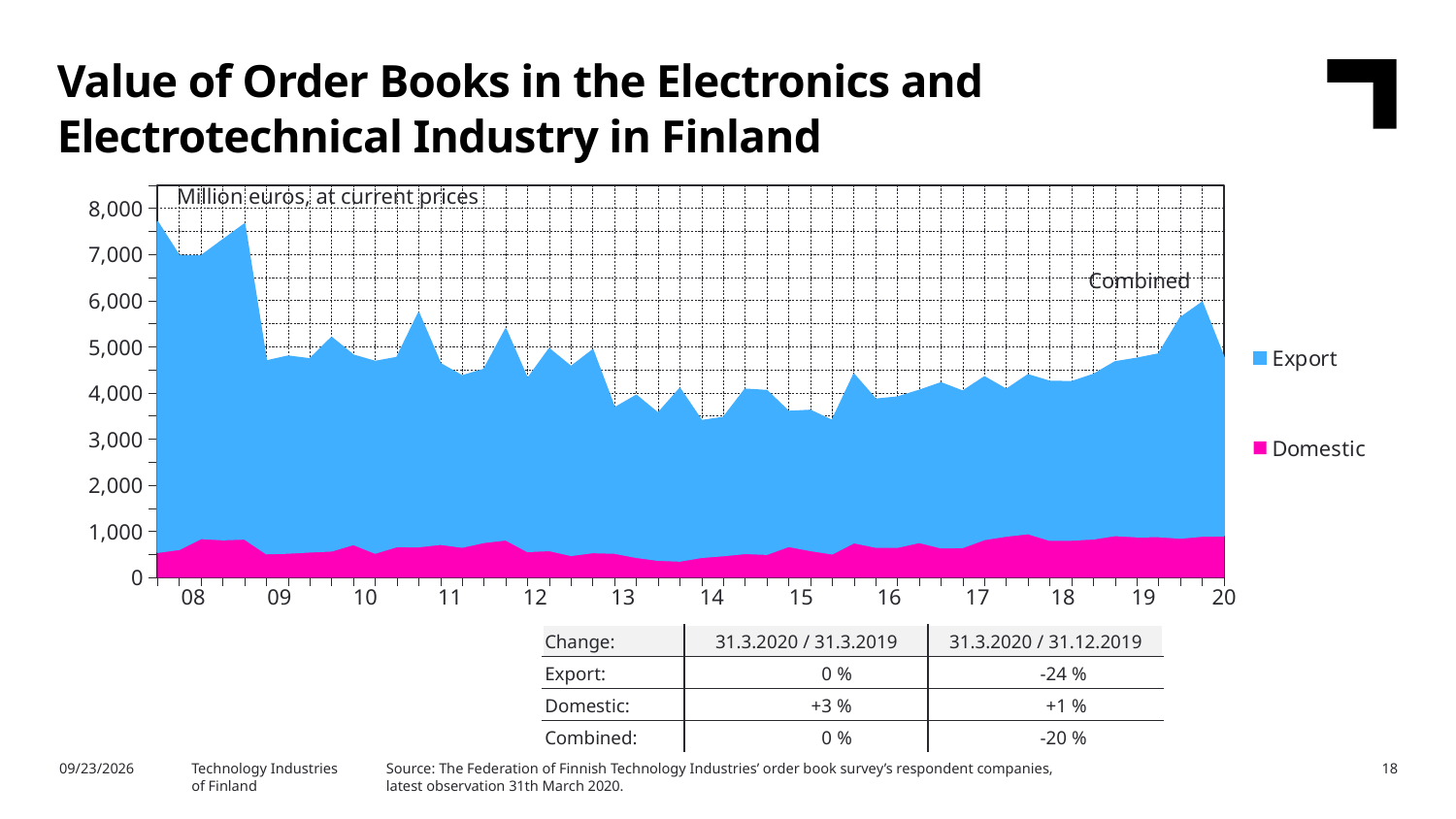
Is the Domestic value in 2018 greater or less than 1,000? less According to the table below the chart, what is the change in Export for 31.3.2020 / 31.12.2019? -24 % In which year does the combined value reach its highest level on the chart? 08 How many series does the chart legend list? 2 Which two series are listed in the chart legend? Export and Domestic Does the combined value rise or fall between 2008 and 2009? fall Which series, Export or Domestic, has the larger values throughout the chart? Export What unit is the chart's vertical axis measured in, according to the label at the top of the chart? Million euros, at current prices What kind of chart is shown on the slide? Area chart According to the table below the chart, what is the change in Domestic for 31.3.2020 / 31.3.2019? +3 %